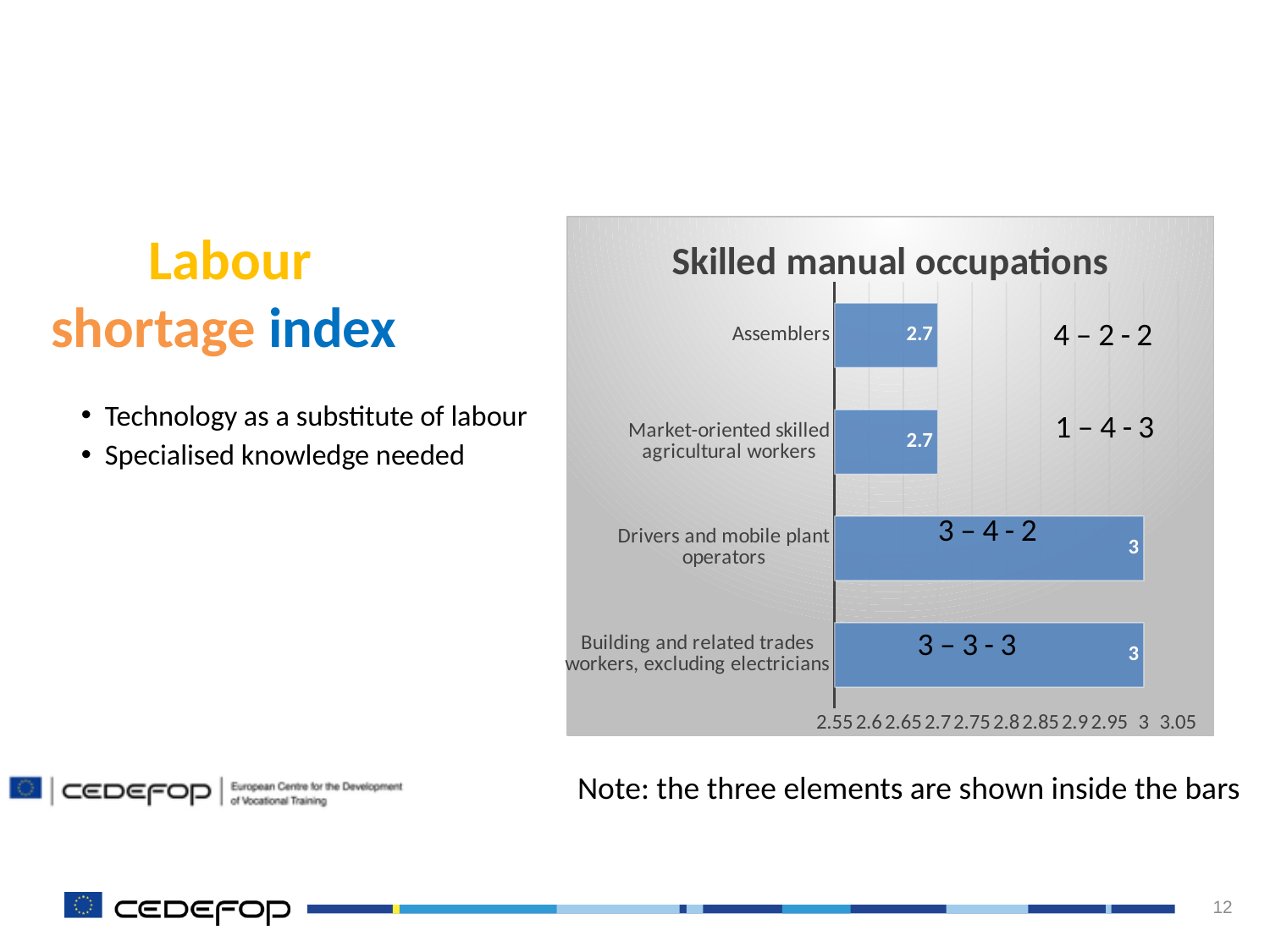
What is the title of the chart? Skilled manual occupations What kind of chart is shown on the slide? Bar chart How many occupation categories are shown in the chart? 4 Which is larger, the value for Assemblers or the value for Drivers and mobile plant operators? Drivers and mobile plant operators What is the value for Building and related trades workers, excluding electricians? 3 What is the value for Market-oriented skilled agricultural workers? 2.7 What is the value for Assemblers in the Skilled manual occupations chart? 2.7 Is the value for Assemblers greater or less than 2.8? less Is the value for Drivers and mobile plant operators greater or less than 2.9? greater What is the value for Drivers and mobile plant operators? 3 What is the difference between the value for Building and related trades workers, excluding electricians and the value for Market-oriented skilled agricultural workers? 0.3 What three-element annotation is shown inside the bar for Drivers and mobile plant operators? 3 – 4 - 2